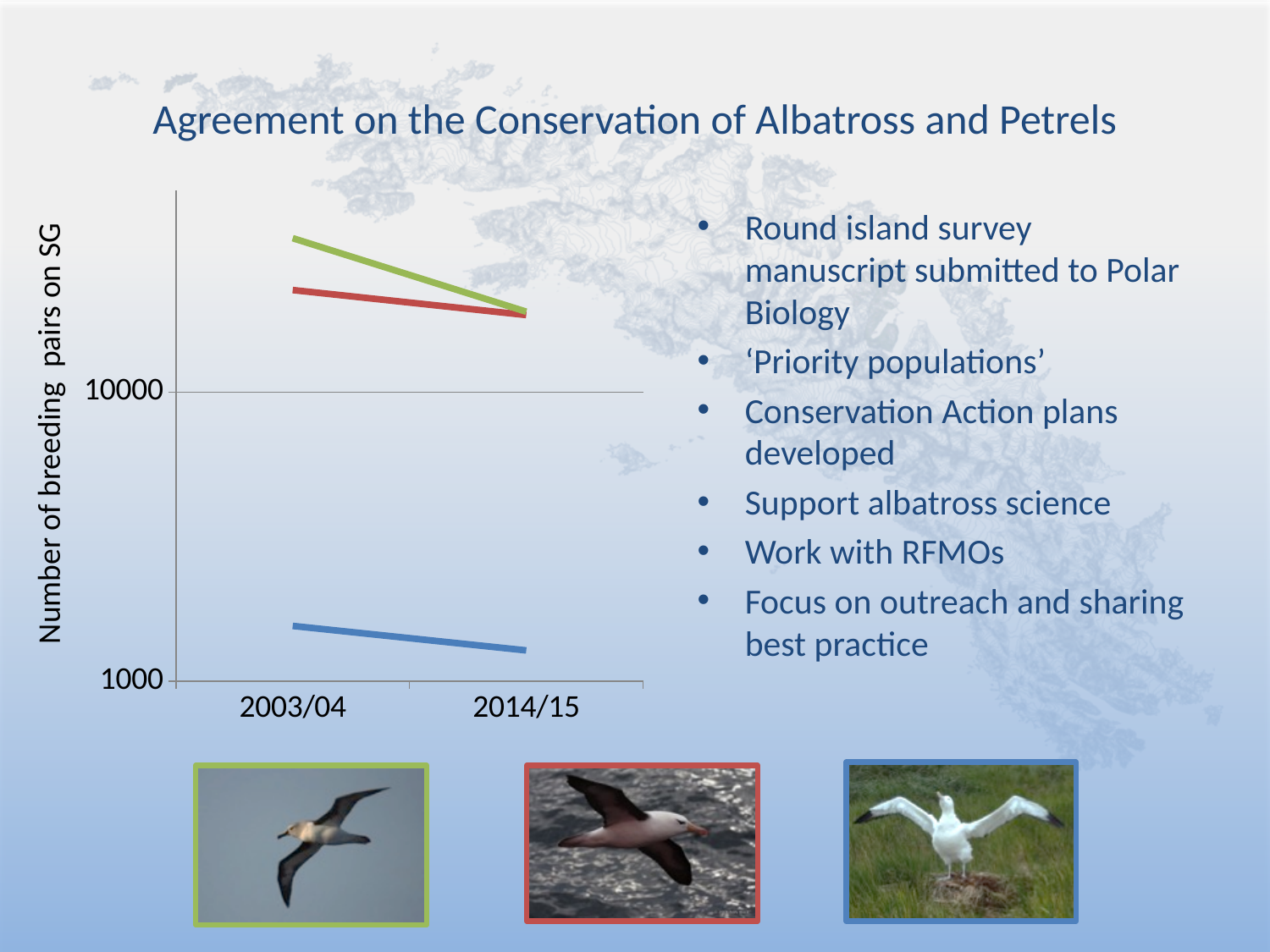
Does the blue line rise or fall from 2003/04 to 2014/15? fall What kind of chart is shown on the slide? line chart Is the value of the green line in 2003/04 greater or less than 10000? greater Which line has the highest value in 2003/04? the green line What are the two x-axis labels on the chart? 2003/04 and 2014/15 Is the value of the blue line in 2014/15 greater or less than 10000? less Does the green line rise or fall from 2003/04 to 2014/15? fall Which line has the lowest value in 2014/15? the blue line How many lines are plotted on the chart? 3 What is the title of the y axis of the chart? Number of breeding pairs on SG How many time points are shown on the x axis of the chart? 2 Does the red line rise or fall from 2003/04 to 2014/15? fall